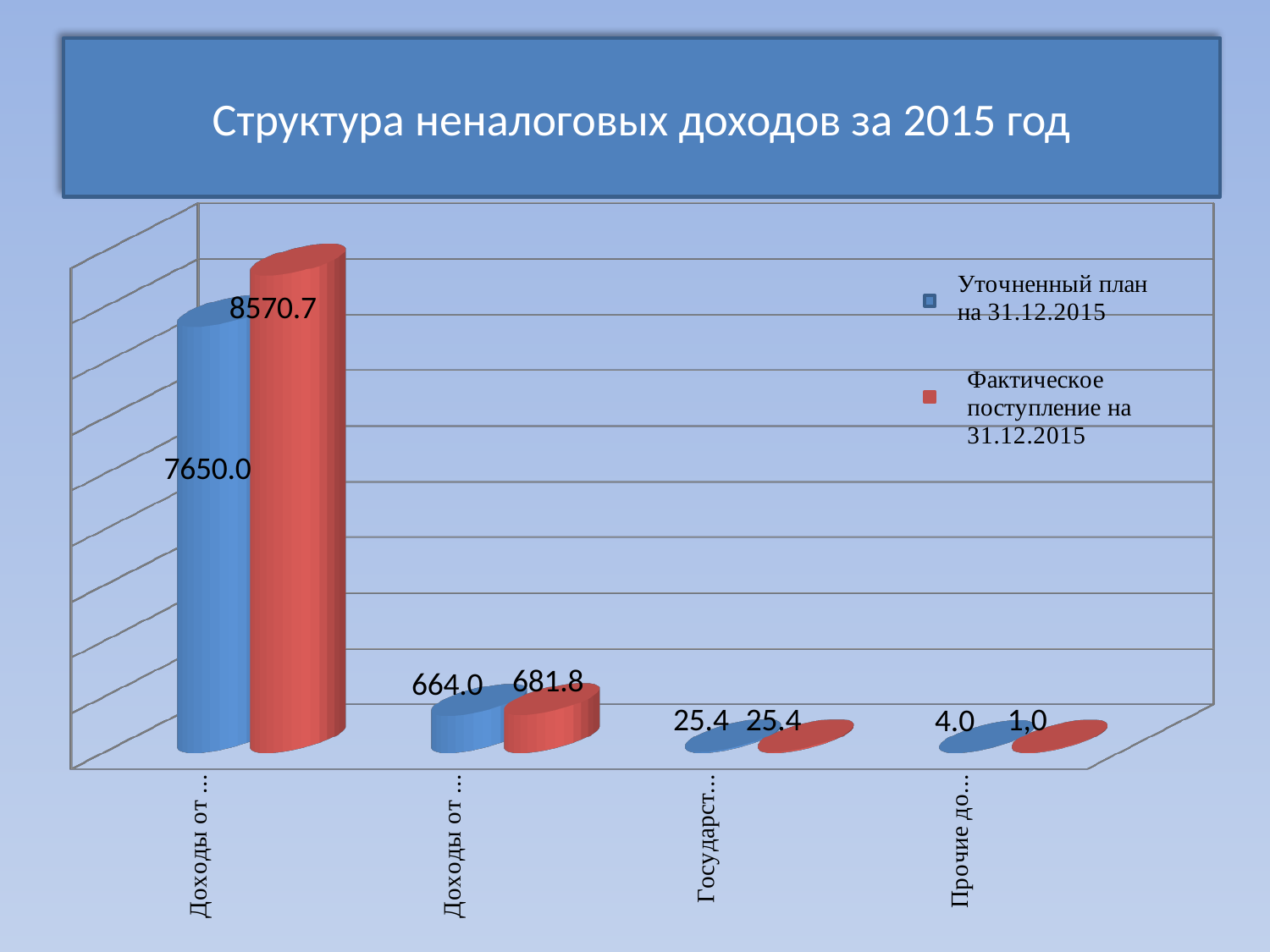
What is the value of 'Уточненный план на 31.12.2015' for the first (leftmost) category? 7650.0 How many series does the legend list? 2 What is the value of 'Фактическое поступление на 31.12.2015' for the first (leftmost) category? 8570.7 What kind of chart is shown on the slide? bar chart For the first (leftmost) category, what is the difference between 'Фактическое поступление на 31.12.2015' and 'Уточненный план на 31.12.2015'? 920.7 What is the value of 'Уточненный план на 31.12.2015' for the category whose label begins 'Государст...'? 25.4 What is the title of the chart? Структура неналоговых доходов за 2015 год What is the value of 'Фактическое поступление на 31.12.2015' for the category whose label begins 'Прочие до...'? 1,0 How many categories are plotted along the x axis? 4 Which category has the highest value for 'Фактическое поступление на 31.12.2015'? the first (leftmost) category For the second category from the left, which is larger: 'Уточненный план на 31.12.2015' or 'Фактическое поступление на 31.12.2015'? Фактическое поступление на 31.12.2015 What is the value of 'Фактическое поступление на 31.12.2015' for the second category from the left? 681.8